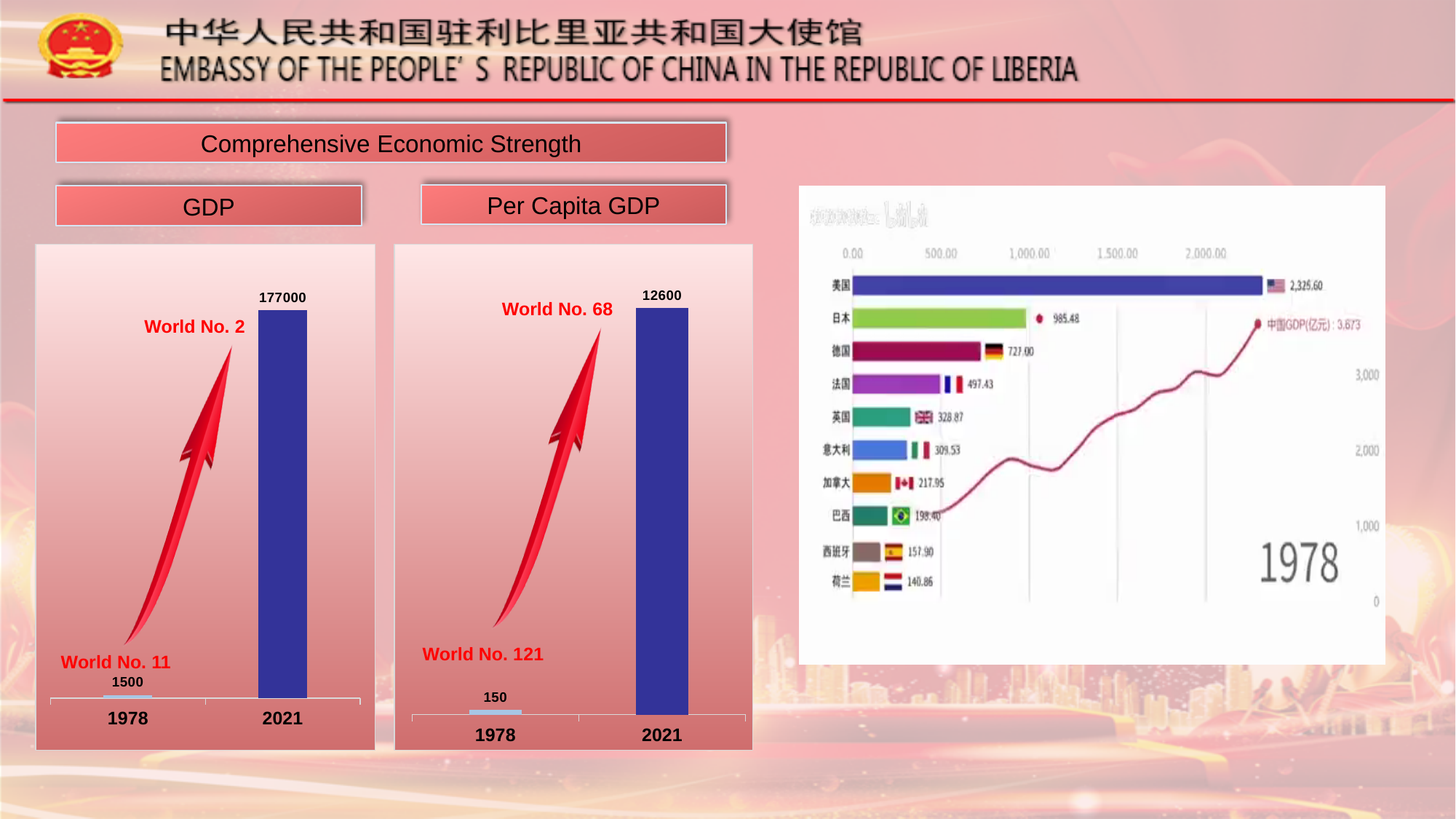
In the Per Capita GDP chart, what is the difference between the 2021 and 1978 values? 12450 How many categories are shown on the x axis of the GDP chart? 2 What kind of chart is the Per Capita GDP chart? Bar chart In the GDP chart, what is the value for 2021? 177000 In the GDP chart, what is the value for 1978? 1500 In the Per Capita GDP chart, which year has the lowest value? 1978 In the GDP chart, do the values rise or fall from 1978 to 2021? Rise In the Per Capita GDP chart, what is the value for 1978? 150 In the Per Capita GDP chart, what is the value for 2021? 12600 In the GDP chart, what world ranking label is shown next to the 2021 bar? World No. 2 In the GDP chart, which year has the higher value, 1978 or 2021? 2021 In the GDP chart, what is the difference between the 2021 and 1978 values? 175500